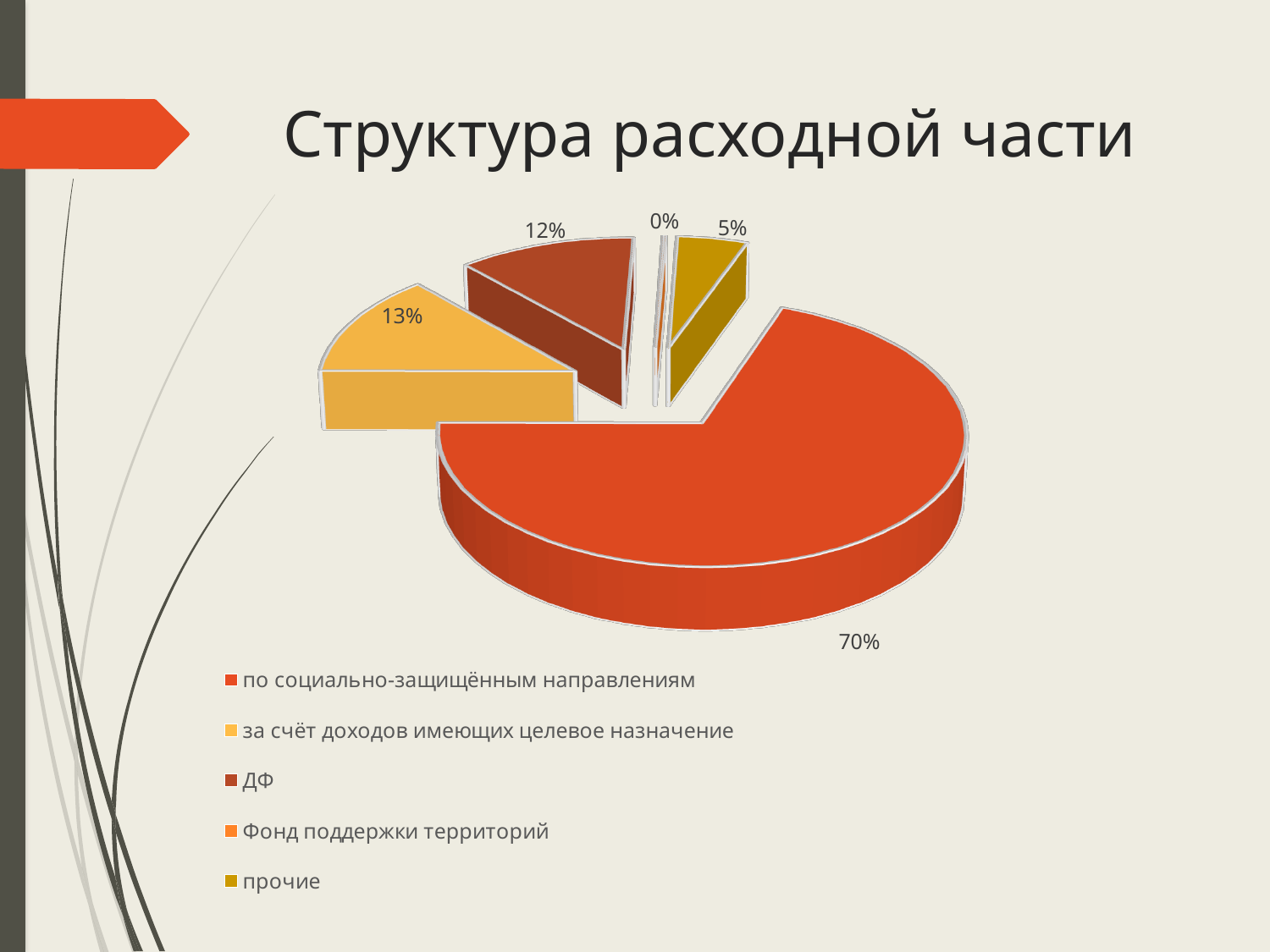
What share of the pie is labelled for "прочие"? 5% How many slices does the pie chart have? 5 Which category has the smallest share of the pie? Фонд поддержки территорий What share of the pie is labelled for "за счёт доходов имеющих целевое назначение"? 13% How many entries does the legend list? 5 Which category has the largest share of the pie? по социально-защищённым направлениям What share of the pie is labelled for "Фонд поддержки территорий"? 0% What is the slide title above the chart? Структура расходной части What is the difference in percentage points between the share for "по социально-защищённым направлениям" and the share for "за счёт доходов имеющих целевое назначение"? 57 percentage points What kind of chart is shown on the slide? pie chart